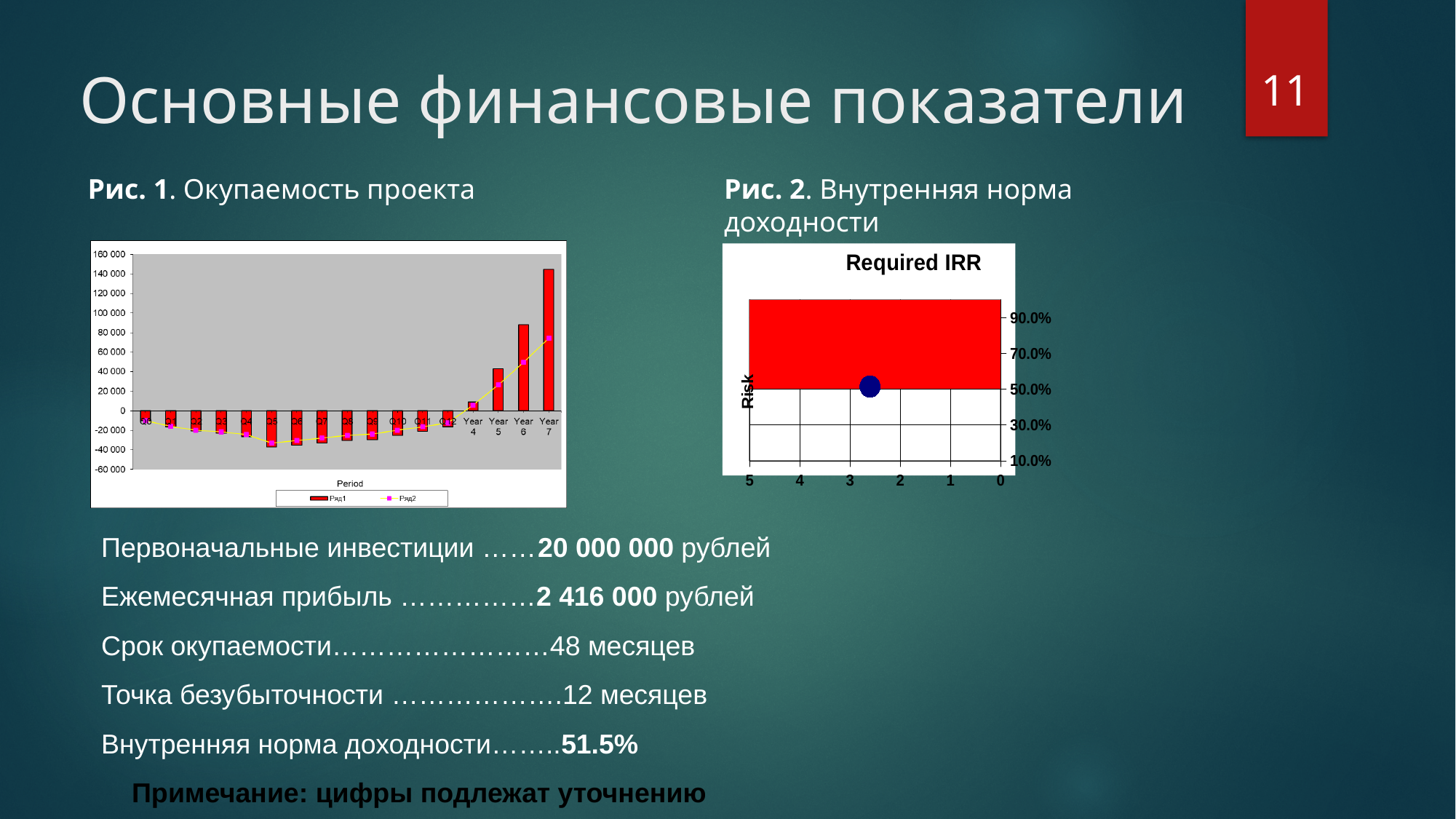
In Рис. 1, is the bar for Year 5 greater or less than 60 000? less In Рис. 1, which bar is taller, Year 5 or Year 6? Year 6 What is the title of the chart in Рис. 2? Required IRR In Рис. 1, is the bar for Year 6 greater or less than 60 000? greater In Рис. 1, which category has the highest bar? Year 7 What kind of chart is Рис. 1 (Окупаемость проекта)? bar chart with a line series What is the label on the vertical axis of the Рис. 2 chart? Risk In Рис. 1, is the bar for Year 7 greater or less than 120 000? greater In Рис. 1, which category has the lowest bar? Q5 How many series does the legend of Рис. 1 list? 2 How many categories are shown on the x axis of Рис. 1? 17 In Рис. 1, do the bars rise or fall from Year 4 to Year 7? rise